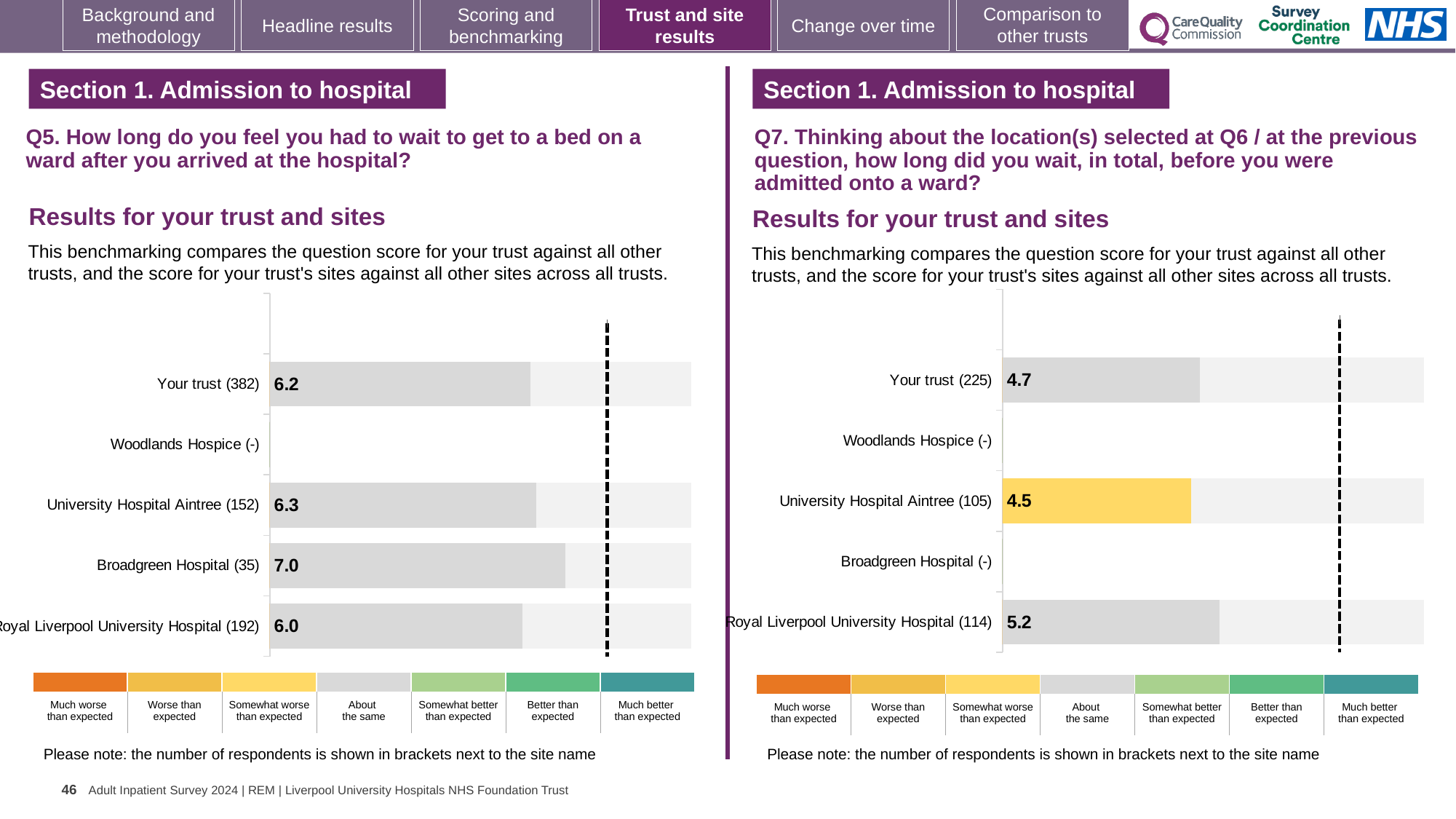
How many site rows (including Your trust) are listed in the left chart (Q5)? 5 In the left chart (Q5), what is the score for Your trust? 6.2 In the right chart (Q7), what is the score for Royal Liverpool University Hospital? 5.2 In the right chart (Q7), what is the score for University Hospital Aintree? 4.5 In the right chart (Q7), which site has the highest score? Royal Liverpool University Hospital In the left chart (Q5), what is the score for Broadgreen Hospital? 7.0 In the left chart (Q5), which site has the highest score? Broadgreen Hospital In the left chart (Q5), what is the difference between the scores for Broadgreen Hospital and Royal Liverpool University Hospital? 1.0 What type of chart is used on this slide? Bar chart In the left chart (Q5), which site has the lowest score among those with a bar shown? Royal Liverpool University Hospital In the right chart (Q7), which has the larger score, Your trust or University Hospital Aintree? Your trust In the right chart (Q7), what is the difference between the scores for Royal Liverpool University Hospital and Your trust? 0.5